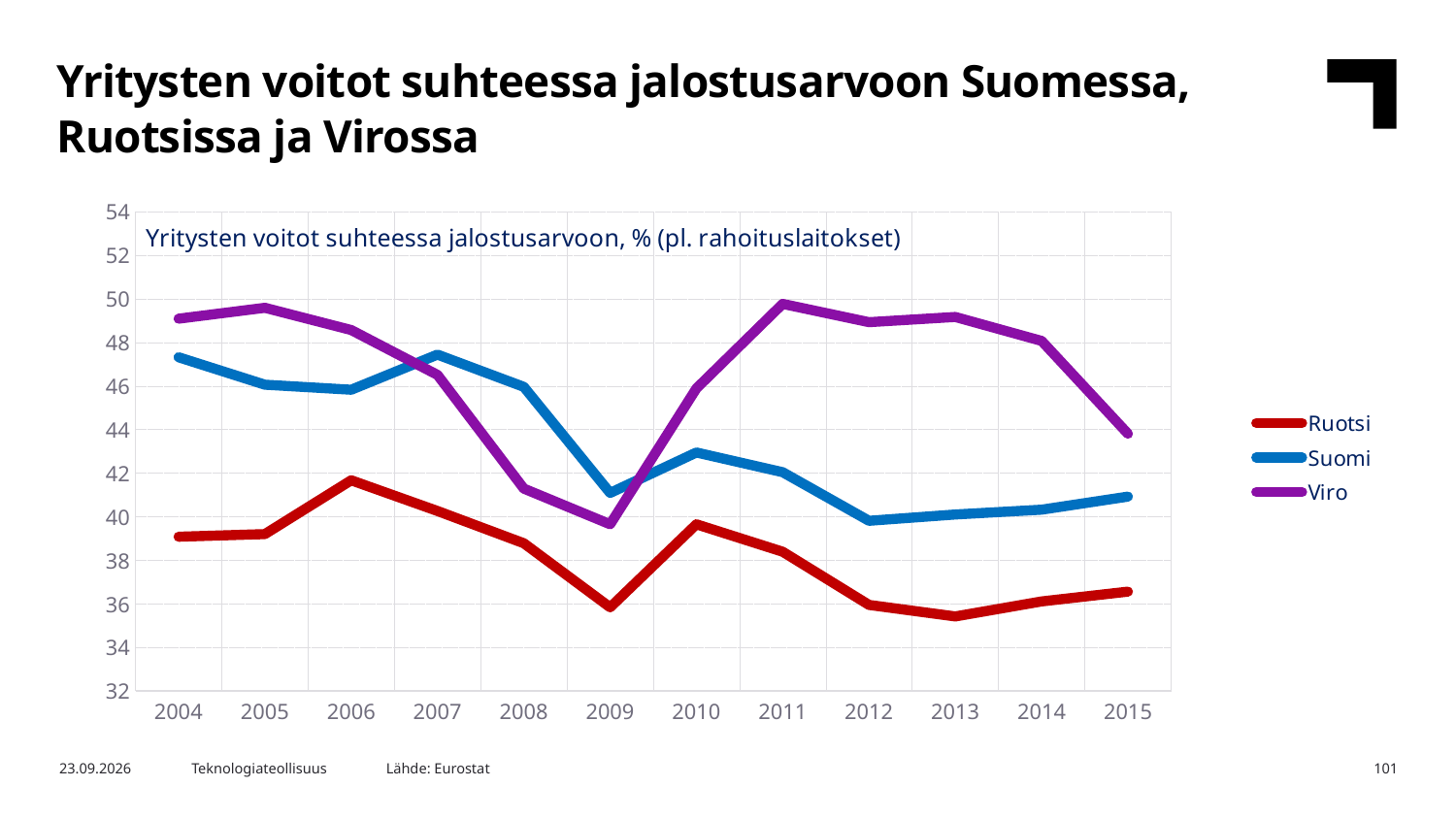
How many years are plotted along the x axis? 12 In which year does the Ruotsi line reach its highest value? 2006 Is the value for Viro in 2011 greater or less than 48? greater Which series has the lowest value in 2004? Ruotsi What is the title printed inside the chart area? Yritysten voitot suhteessa jalostusarvoon, % (pl. rahoituslaitokset) Does the Viro line rise or fall from 2011 to 2015? fall Which is larger in 2008, the value for Suomi or the value for Viro? Suomi Which series has the highest value in 2011? Viro How many series does the legend list? 3 What kind of chart is shown on the slide? line chart Is the value for Ruotsi in 2009 greater or less than 38? less Is the value for Suomi in 2012 greater or less than 42? less